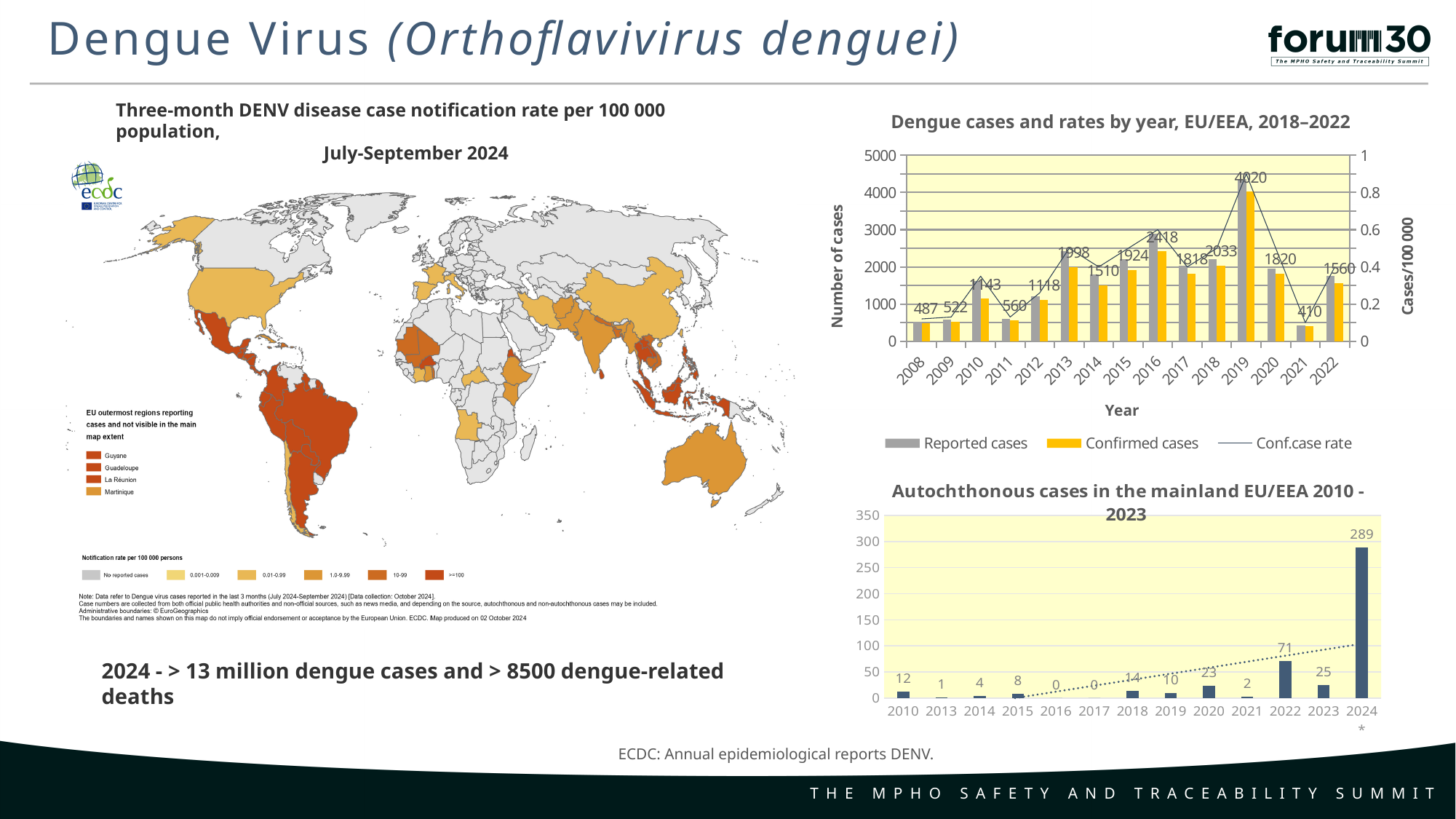
What kind of chart is the 'Autochthonous cases in the mainland EU/EEA' chart? bar chart In the 'Dengue cases and rates by year, EU/EEA' chart, which year has the lowest labelled value? 2021 In the 'Dengue cases and rates by year, EU/EEA' chart, what value is labelled for 2019? 4020 In the 'Dengue cases and rates by year, EU/EEA' chart, which year has the highest labelled value? 2019 In the 'Autochthonous cases in the mainland EU/EEA' chart, which year has the highest value? 2024* How many series does the legend of the 'Dengue cases and rates by year, EU/EEA' chart list? 3 How many years are shown on the x axis of the 'Autochthonous cases in the mainland EU/EEA' chart? 13 In the 'Autochthonous cases in the mainland EU/EEA' chart, what is the value for 2022? 71 In the 'Autochthonous cases in the mainland EU/EEA' chart, is the value for 2023 larger or smaller than the value for 2020? larger In the 'Dengue cases and rates by year, EU/EEA' chart, what value is labelled for 2021? 410 In the 'Autochthonous cases in the mainland EU/EEA' chart, what is the value for 2024*? 289 In the 'Dengue cases and rates by year, EU/EEA' chart, what is the difference between the labelled values for 2016 and 2017? 600